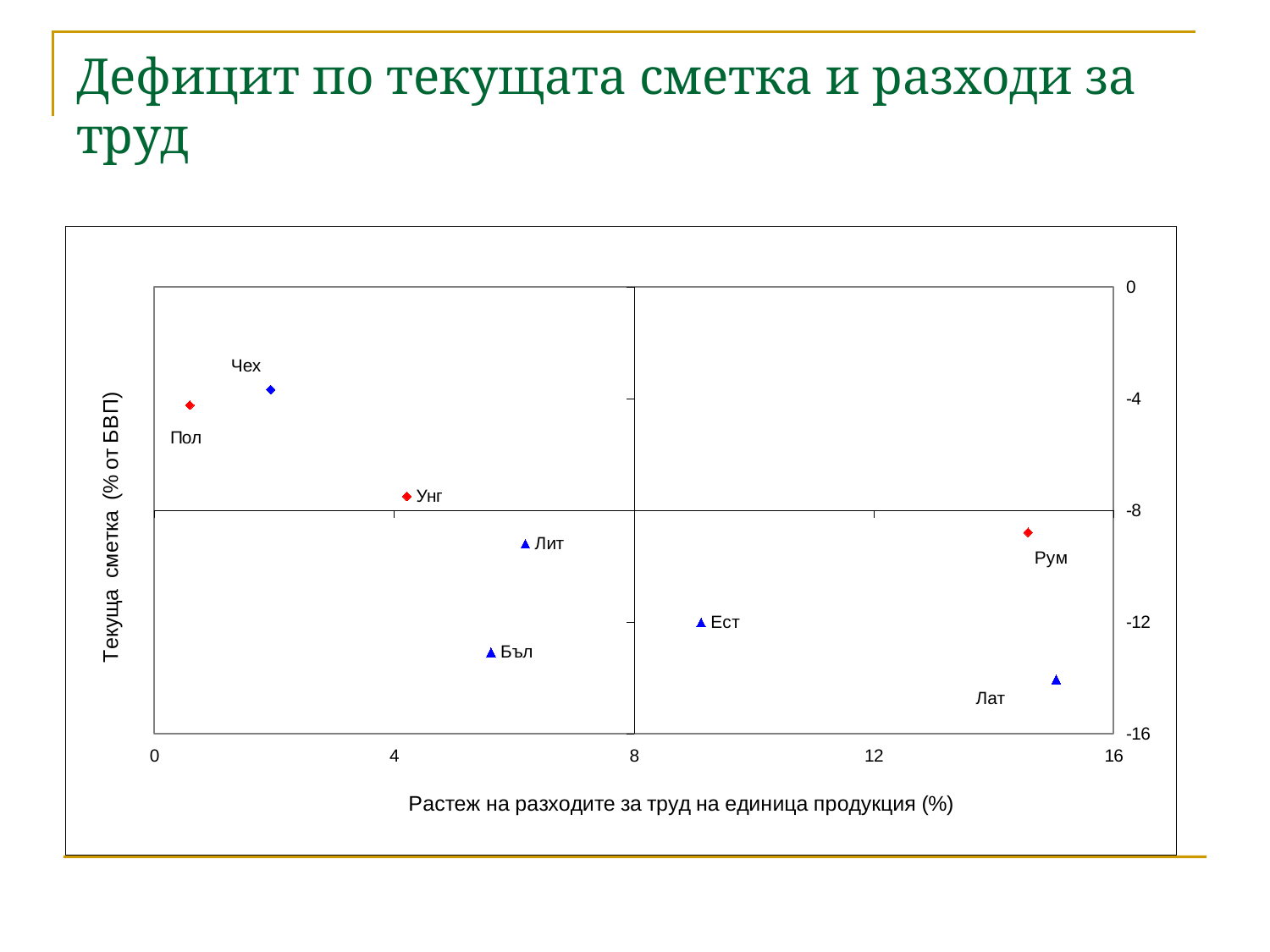
What is the title of the y axis? Текуща сметка (% от БВП) Which country has the lowest current account value (Текуща сметка) on the chart? Лат Is the current account value for Лит greater or less than -12? greater What kind of chart is shown on the slide? scatter chart Is the current account value for Лат greater or less than -12? less Which country has the lowest value on the x axis (Растеж на разходите за труд на единица продукция)? Пол What is the title of the x axis? Растеж на разходите за труд на единица продукция (%) How many countries are plotted on the chart? 8 Which has the larger x-axis value, Ест or Бъл? Ест Is the x-axis value for Рум greater or less than 12? greater